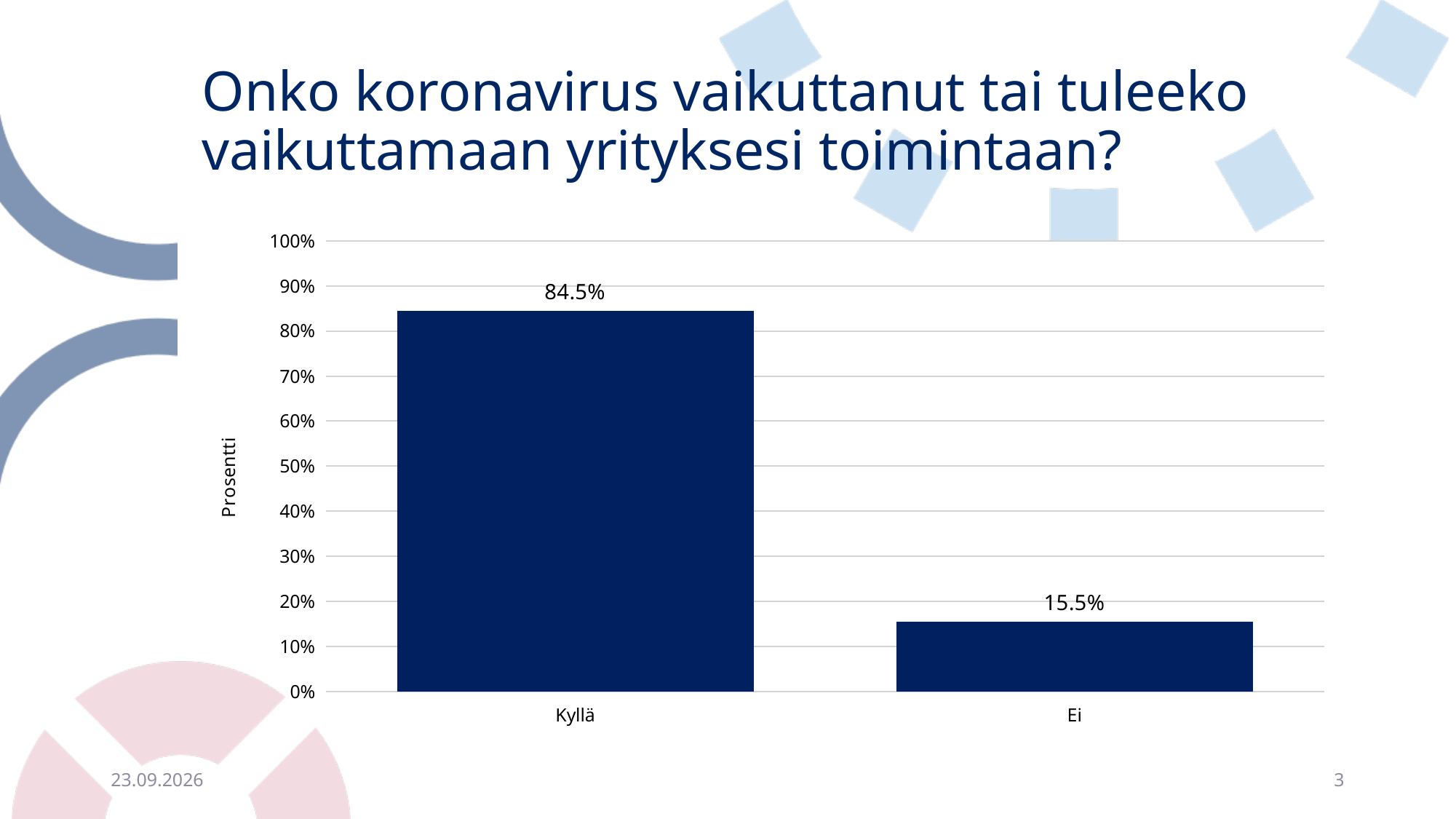
What is the value for Kyllä? 84.5% Is the value for Ei greater or less than 20%? less How many categories are shown on the x axis? 2 What is the value for Ei? 15.5% What is the difference between the values for Kyllä and Ei? 69 percentage points Which category has the highest value? Kyllä What kind of chart is shown on the slide? bar chart Which category has the lowest value? Ei Is the value for Kyllä greater or less than 80%? greater What is the highest value shown on the vertical axis? 100% What is the label of the vertical axis? Prosentti Which is larger, the value for Kyllä or the value for Ei? Kyllä